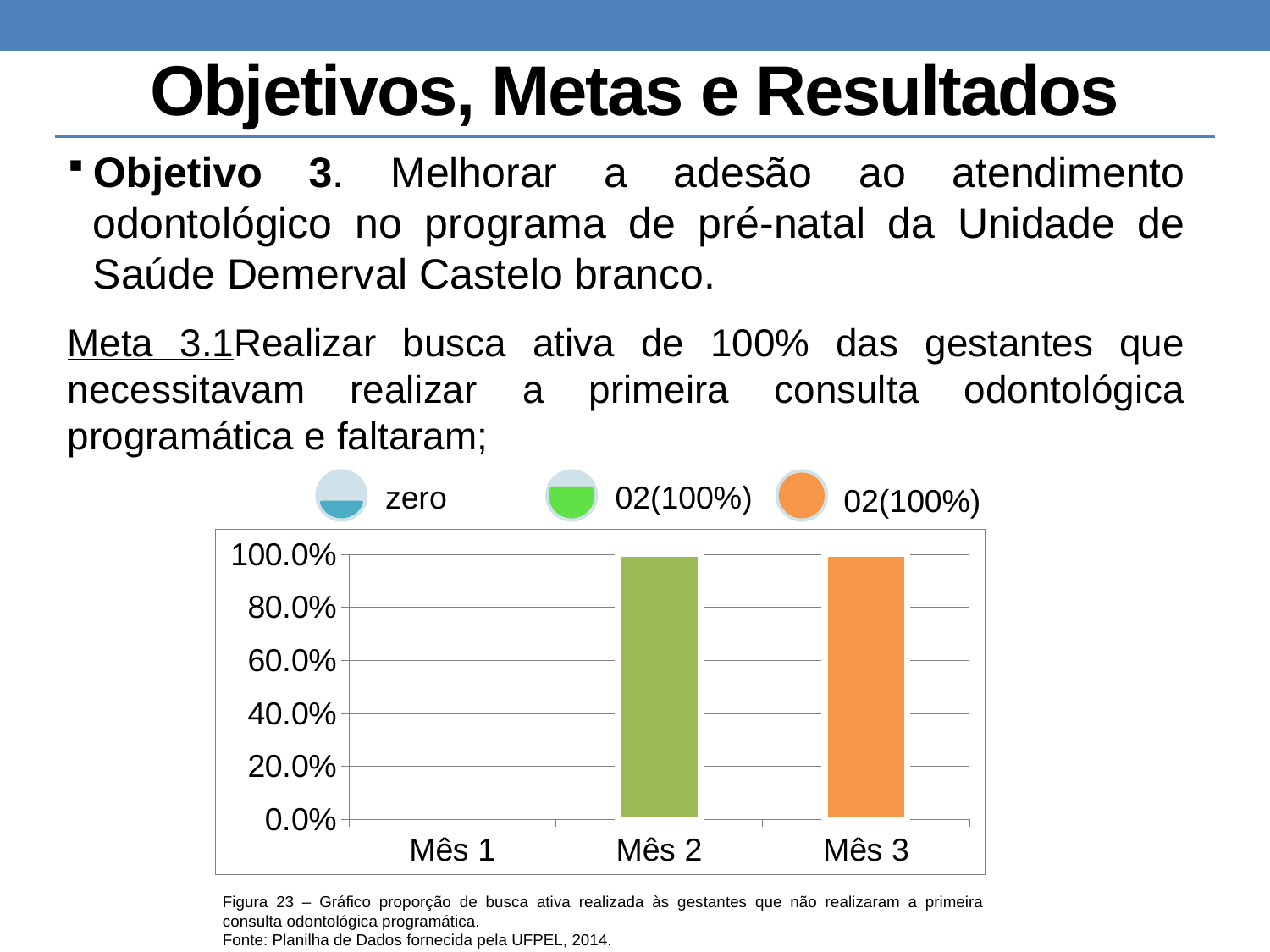
What colour is the bar for Mês 3? orange What kind of chart is shown on the slide? bar chart Is the value for Mês 3 greater or less than 80.0%? greater What value does the bar for Mês 2 reach on the y axis? 100.0% Which month has the lowest value in the chart? Mês 1 What value does the bar for Mês 3 reach on the y axis? 100.0% What is the difference between the value for Mês 2 and the value for Mês 1? 100% What label is printed above the chart for Mês 1? zero How many categories (months) are shown on the x axis of the chart? 3 What label is printed above the chart for Mês 2? 02(100%) Which is larger, the value for Mês 1 or the value for Mês 2? Mês 2 Do the values rise or fall from Mês 1 to Mês 3? rise